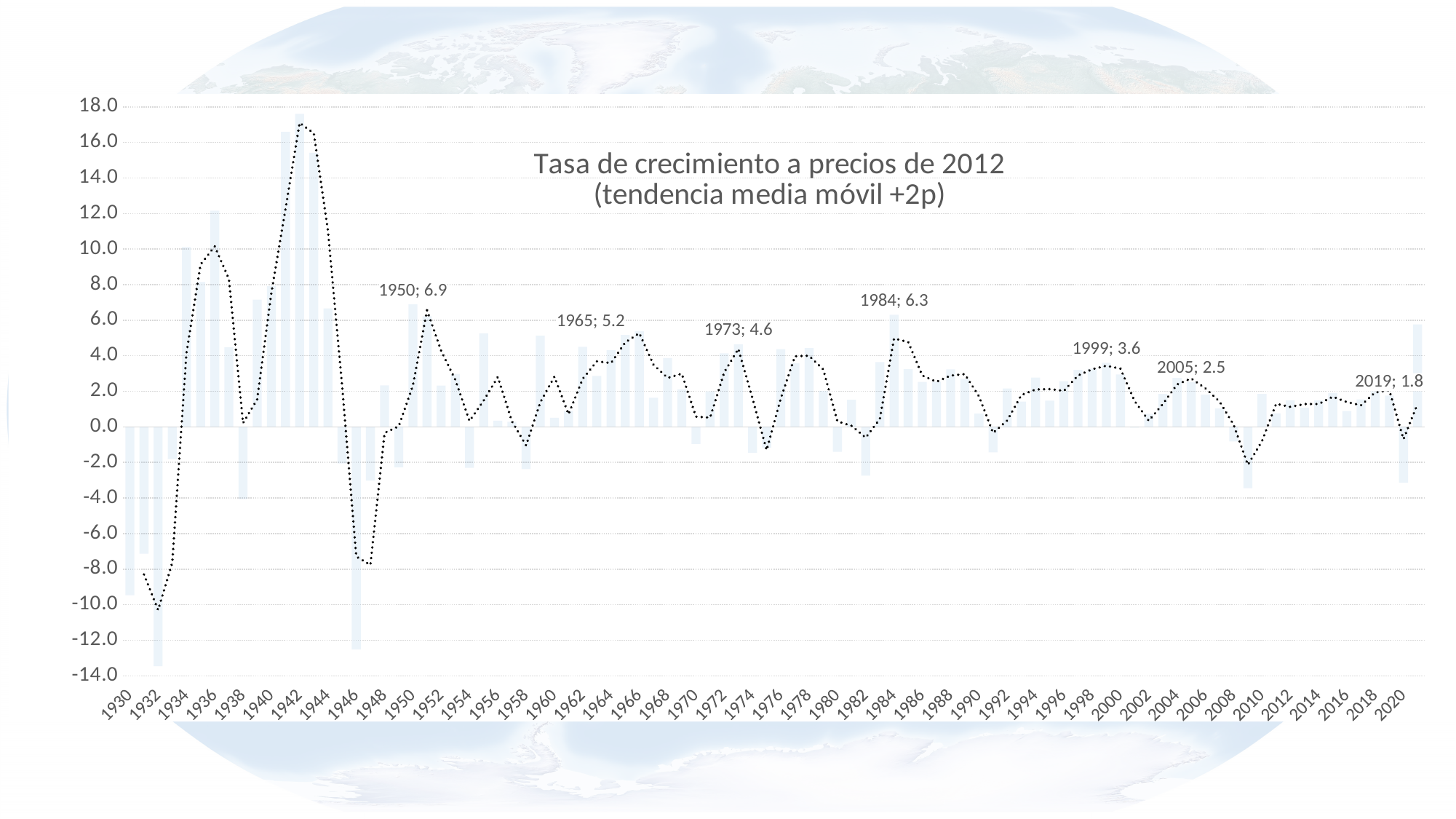
What is the difference between the labelled trend values for 1950 and 1965? 1.7 Is the bar value for 1932 greater or less than -10.0? less What value is labelled on the trend line for 1973? 4.6 What value is labelled on the trend line for 1984? 6.3 Among the labelled points on the trend line, which year has the lowest value? 2019 Do the labelled peak values on the trend line rise or fall from 1950 to 2019? fall Which labelled trend value is larger, 1999 or 2005? 1999 Among the labelled points on the trend line, which year has the highest value? 1950 What is the title of the chart? Tasa de crecimiento a precios de 2012 (tendencia media móvil +2p) What value is labelled on the trend line for 1950? 6.9 Is the bar value for 1942 greater or less than 16.0? greater What value is labelled on the trend line for 2019? 1.8